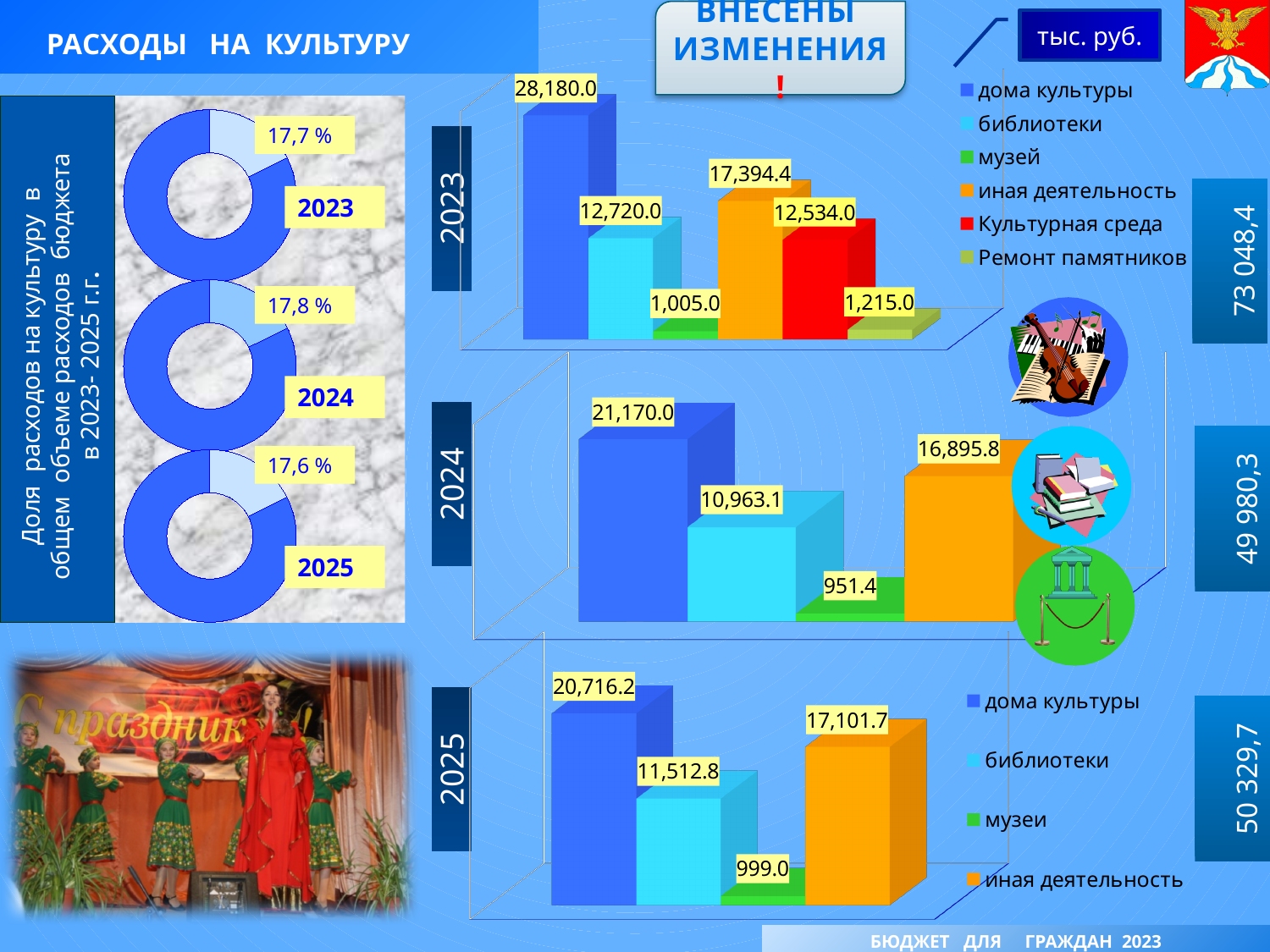
In the 2023 bar chart, what is the value for Ремонт памятников? 1,215.0 In the 2025 bar chart, what is the difference between иная деятельность and библиотеки? 5,588.9 In the 2023 bar chart, what is the value for дома культуры? 28,180.0 In the 2025 bar chart, what is the value for музеи? 999.0 In the 2024 bar chart, which category has the highest value? дома культуры In the 2023 bar chart, what is the difference between дома культуры and библиотеки? 15,460.0 In the 2024 bar chart, what is the value for иная деятельность? 16,895.8 In the 2023 bar chart, which category has the lowest value? музей In the 2024 bar chart, which is larger: библиотеки or музей? библиотеки In the donut chart for 2024 on the left, what share of total budget expenditure is spent on culture? 17,8 % In the 2023 bar chart, how many series does the legend list? 6 In the 2025 bar chart, how many categories are plotted? 4